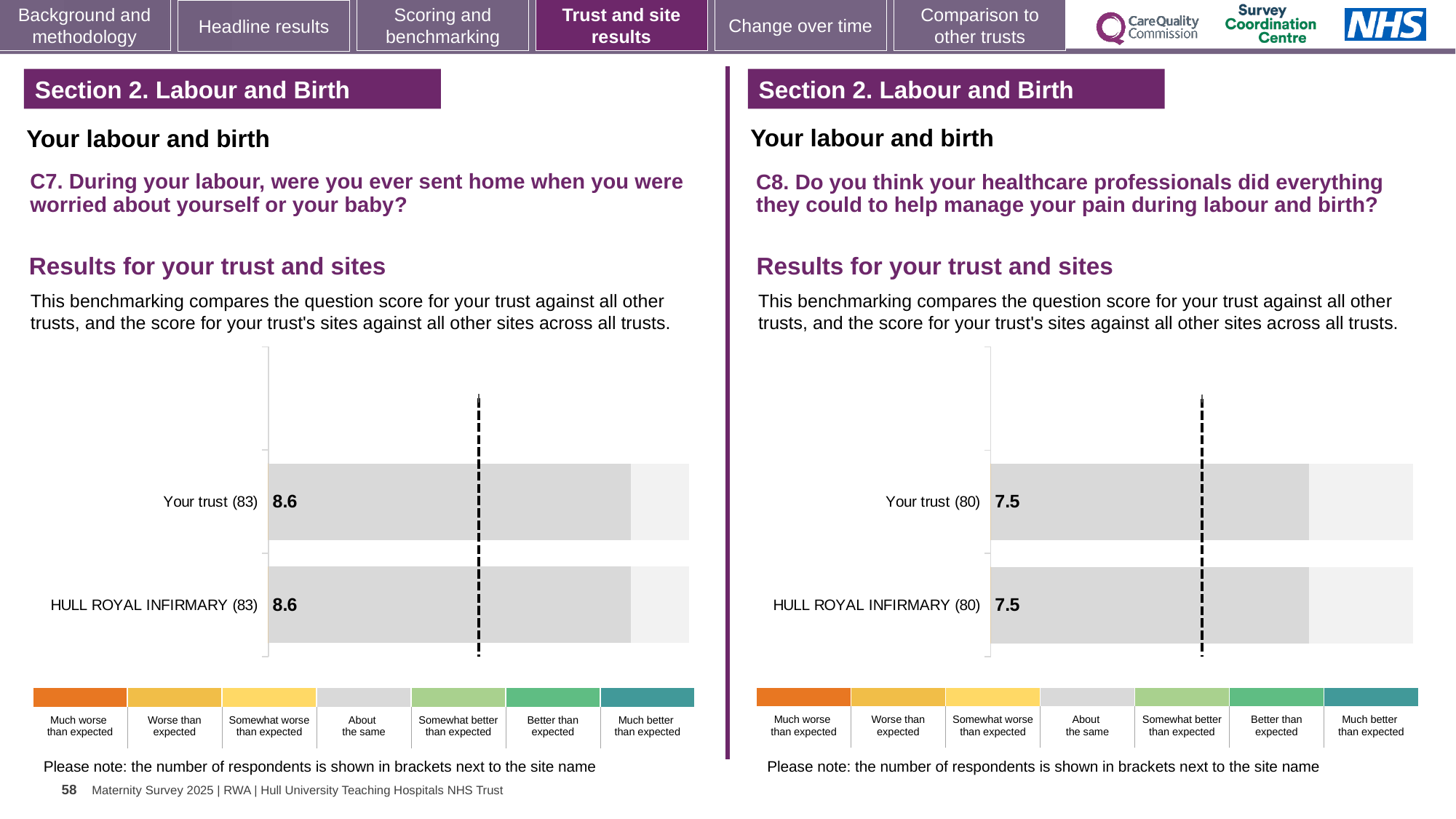
In the right chart (C8), what is the score for HULL ROYAL INFIRMARY? 7.5 In the right chart (C8), how many respondents are shown in brackets next to HULL ROYAL INFIRMARY? 80 In the right chart (C8), what is the difference between the score for Your trust and the score for HULL ROYAL INFIRMARY? 0 What kind of chart is used in the left chart (C7)? Bar chart How many bars are plotted in the left chart (C7)? 2 In the left chart (C7), how many respondents are shown in brackets next to Your trust? 83 In the left chart (C7), what is the difference between the score for Your trust and the score for HULL ROYAL INFIRMARY? 0 In the left chart (C7), what is the score for HULL ROYAL INFIRMARY? 8.6 Is the score for Your trust in the left chart (C7) larger or smaller than the score for Your trust in the right chart (C8)? Larger In the left chart (C7), what is the score for Your trust? 8.6 How many bars are plotted in the right chart (C8)? 2 In the right chart (C8), what is the score for Your trust? 7.5